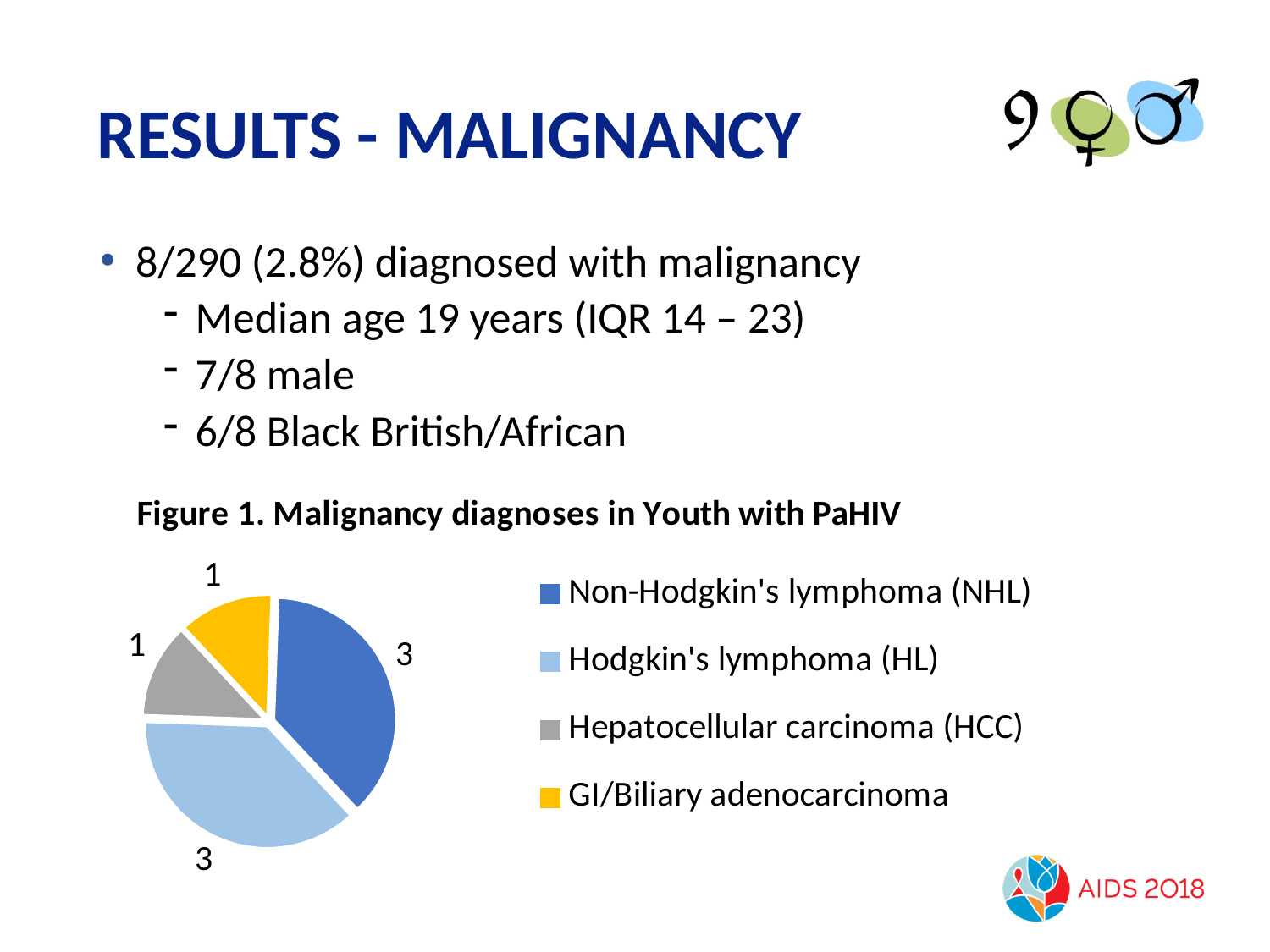
How many diagnoses are shown for Non-Hodgkin's lymphoma (NHL) in the pie chart? 3 How many entries does the legend of the pie chart list? 4 How many diagnoses are shown for Hodgkin's lymphoma (HL) in the pie chart? 3 How many diagnoses are shown for GI/Biliary adenocarcinoma in the pie chart? 1 How many diagnoses are shown for Hepatocellular carcinoma (HCC) in the pie chart? 1 What share of the pie does Non-Hodgkin's lymphoma (NHL) represent? 37.5% What is the total number of diagnoses across all slices of the pie chart? 8 What is the difference between the number of Hodgkin's lymphoma (HL) diagnoses and GI/Biliary adenocarcinoma diagnoses? 2 What type of chart is shown in Figure 1? pie chart How many slices does the pie chart have? 4 Which has more diagnoses in the pie chart, Non-Hodgkin's lymphoma (NHL) or Hepatocellular carcinoma (HCC)? Non-Hodgkin's lymphoma (NHL) What share of the pie does Hepatocellular carcinoma (HCC) represent? 12.5%